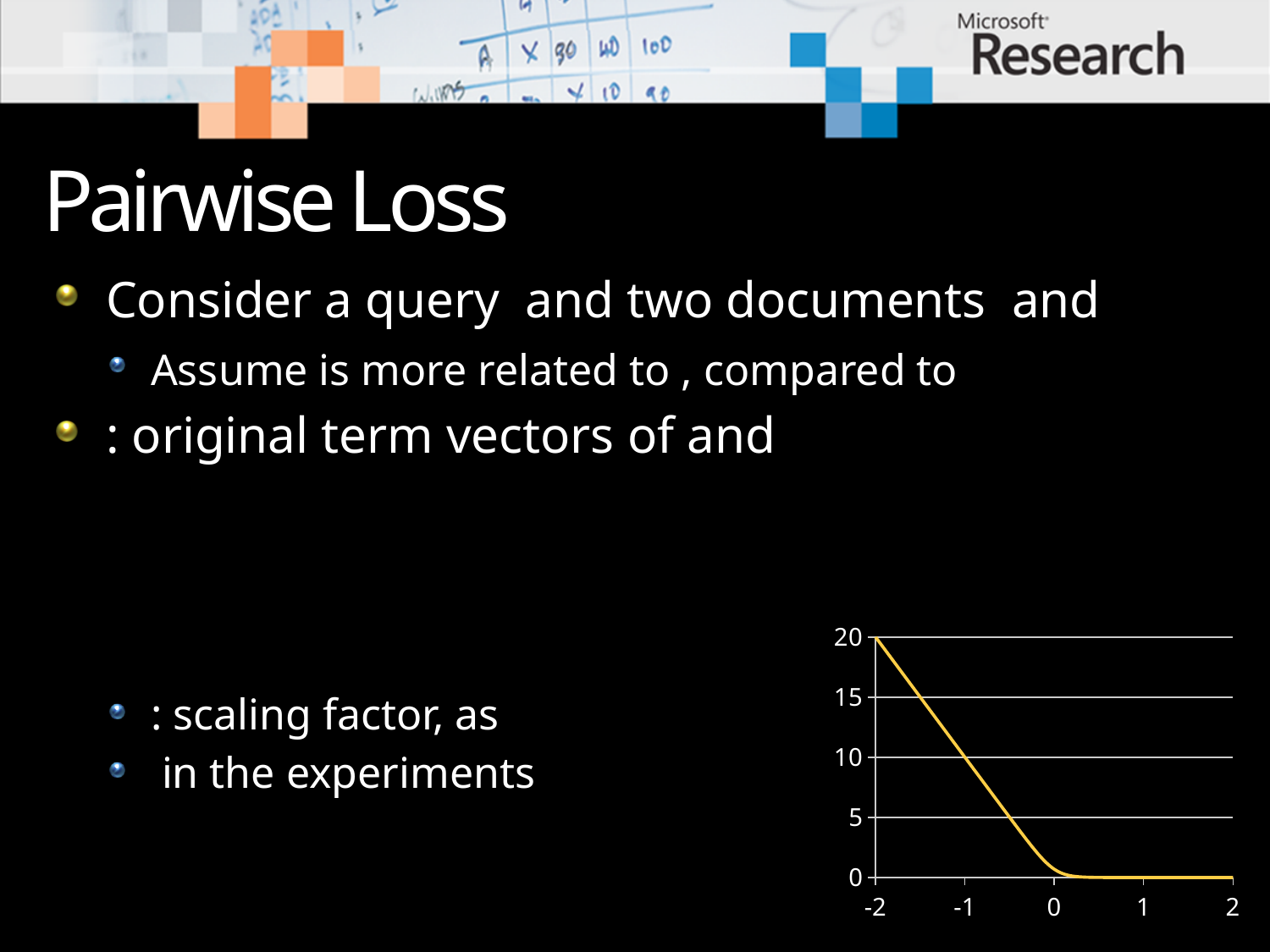
Is the curve's value at x = -1 larger or smaller than its value at x = 1? larger How many tick labels are shown on the x axis of the chart? 5 What colour is the line plotted on the chart? yellow Is the value of the curve at x = -0.5 greater or less than 10? less What is the highest value labelled on the y axis of the chart? 20 Is the value of the curve at x = 0 greater or less than 5? less Is the value of the curve at x = -1.5 greater or less than 10? greater Do the values on the chart rise or fall as x increases from -2 to 2? fall What kind of chart is shown on the slide? line chart At which labelled x value is the curve highest? -2 What is the value of the curve at x = -2? 20